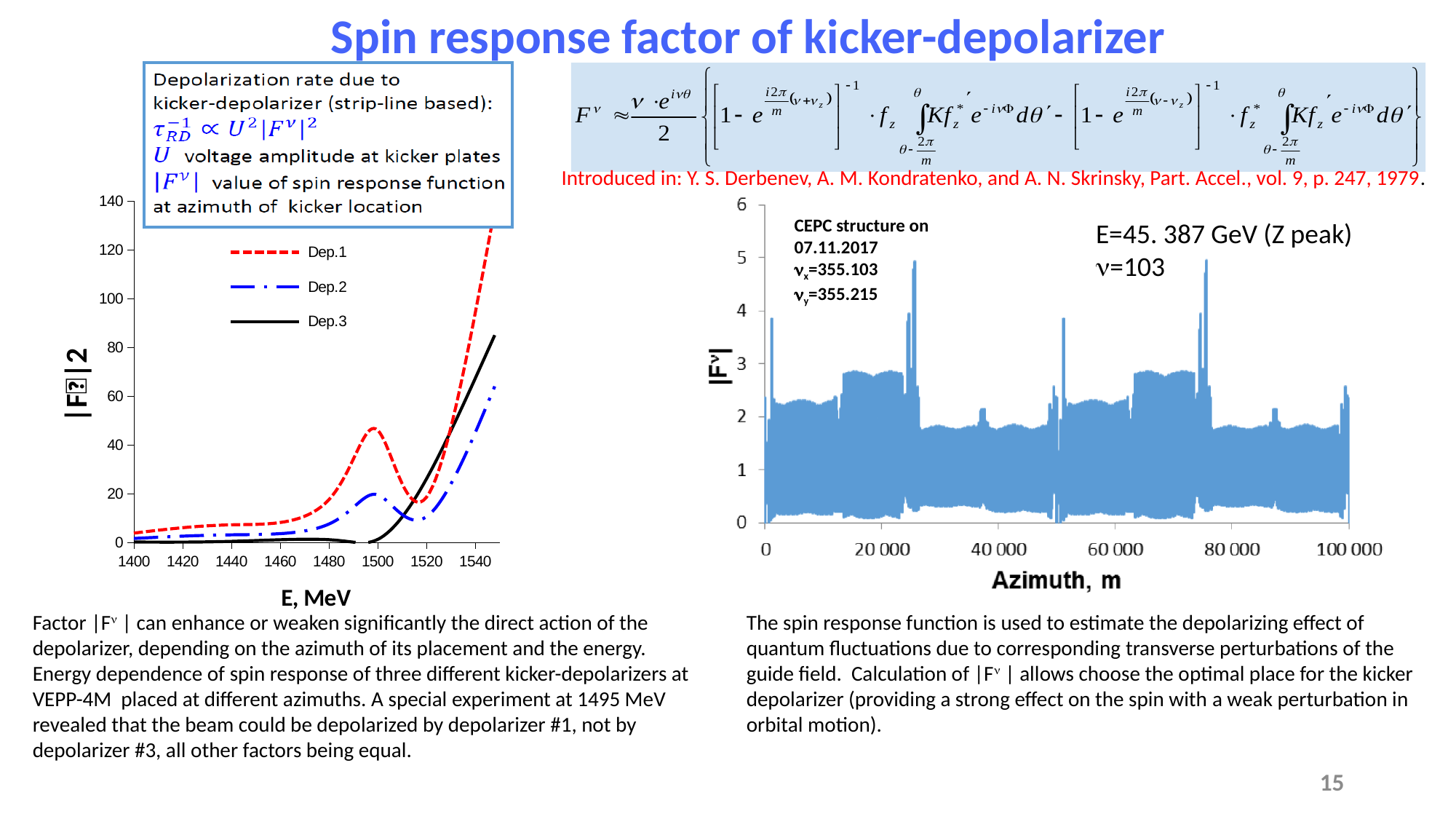
On the left chart, is the value of Dep.1 at 1540 MeV greater or less than 80? greater On the left chart (|F|^2 vs E, MeV), how many series does the legend list? 3 What kind of chart is the left chart plotting |F|^2 against E, MeV? line chart On the right chart (|Fν| vs Azimuth, m), is the maximum value of |Fν| greater or less than 4? greater On the right chart, what is the label of the x axis? Azimuth, m On the left chart, does the Dep.3 curve rise or fall between 1500 MeV and 1540 MeV? rise On the left chart, is the value of Dep.1 at 1500 MeV greater or less than 20? greater On the left chart, which series has the highest value at 1540 MeV? Dep.1 On the left chart, which series has the lowest value at 1500 MeV? Dep.3 On the left chart, which series shows a pronounced peak near 1500 MeV? Dep.1 On the left chart, what are the names of the series in the legend? Dep.1, Dep.2, Dep.3